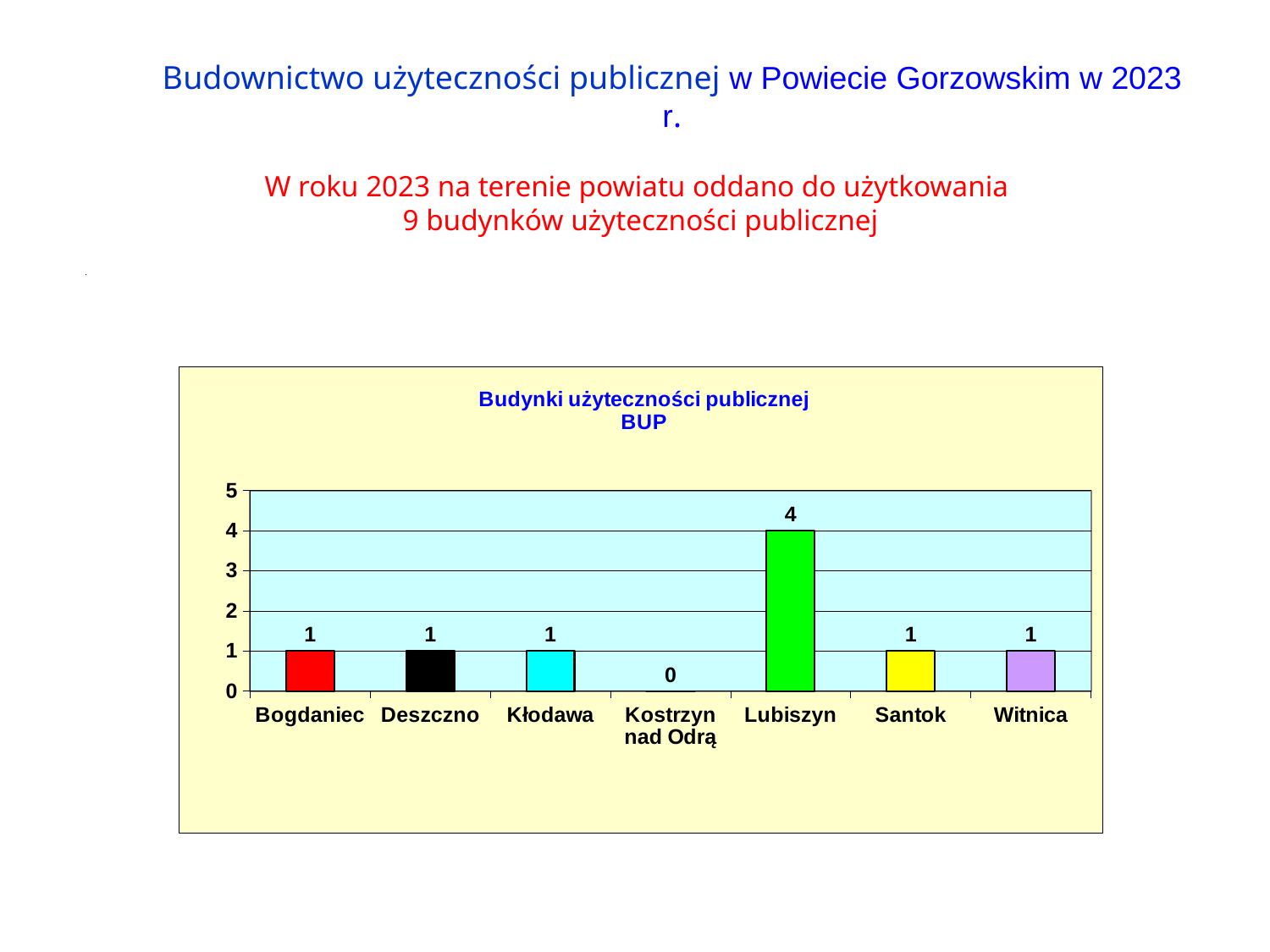
Which is larger, the value for Lubiszyn or the value for Witnica? Lubiszyn What is the title of the chart? Budynki użyteczności publicznej BUP How many categories are shown on the x axis? 7 What is the value for Kostrzyn nad Odrą? 0 What is the value for Lubiszyn? 4 What is the difference between the values for Lubiszyn and Bogdaniec? 3 Which category has the highest value? Lubiszyn What is the highest value shown on the y axis? 5 Which category has the lowest value? Kostrzyn nad Odrą What is the value for Santok? 1 What kind of chart is shown? Bar chart What colour is the bar for Lubiszyn? Green